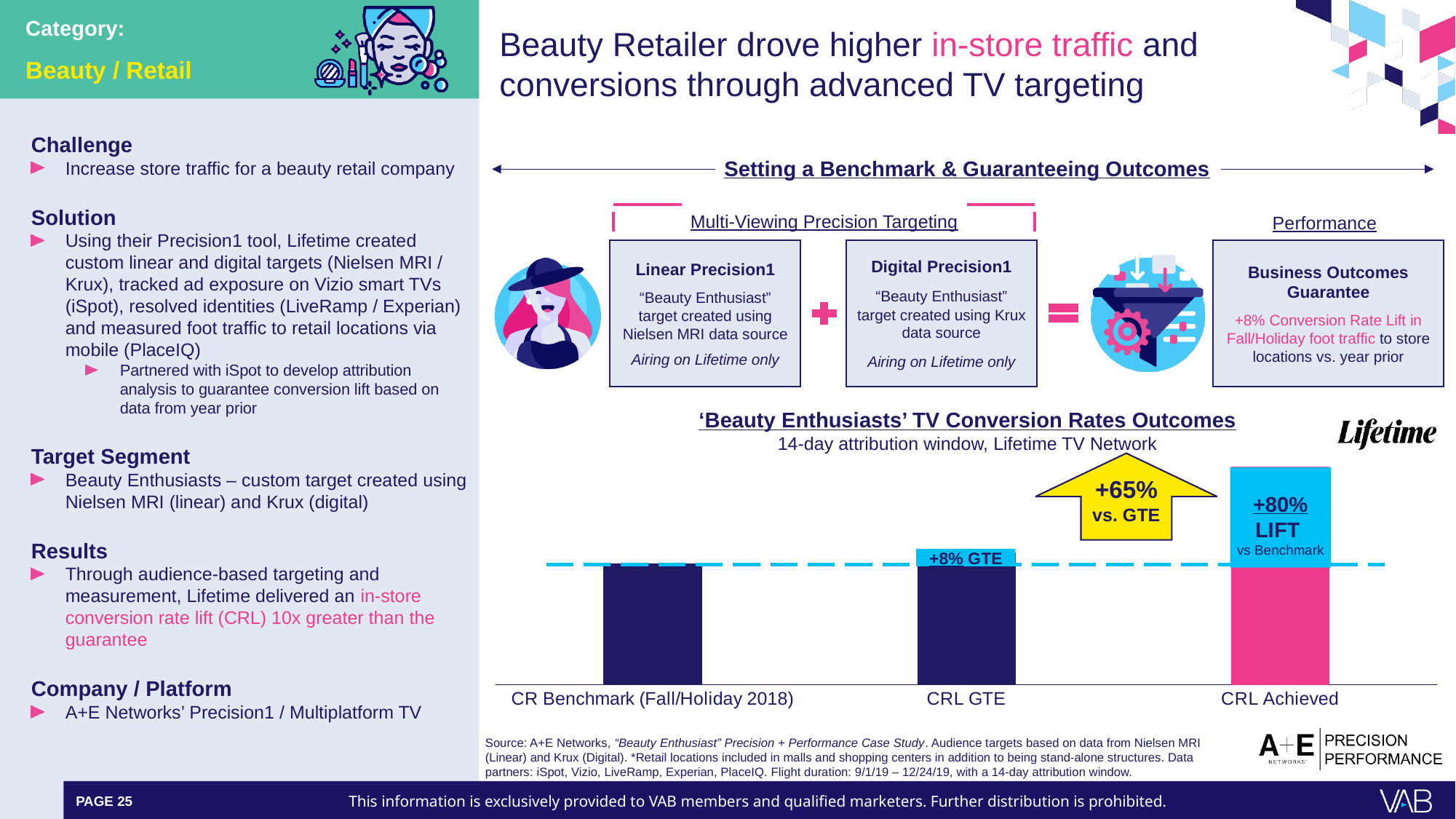
What is the subtitle printed beneath the chart title? 14-day attribution window, Lifetime TV Network What label is printed on the CRL GTE bar? +8% GTE Which bar is taller, CRL GTE or CRL Achieved? CRL Achieved Which category has the tallest bar in the conversion rates outcomes chart? CRL Achieved What colour is the CRL Achieved bar? Pink How many bars are plotted in the ‘Beauty Enthusiasts’ TV Conversion Rates Outcomes chart? 3 According to the arrow on the chart, how much higher is CRL Achieved vs. GTE? +65% What kind of chart is shown under the title ‘Beauty Enthusiasts’ TV Conversion Rates Outcomes? Bar chart Do the bar heights rise or fall from left to right across the chart? Rise What lift vs benchmark is printed on the CRL Achieved bar? +80% Which category has the shortest bar in the conversion rates outcomes chart? CR Benchmark (Fall/Holiday 2018)